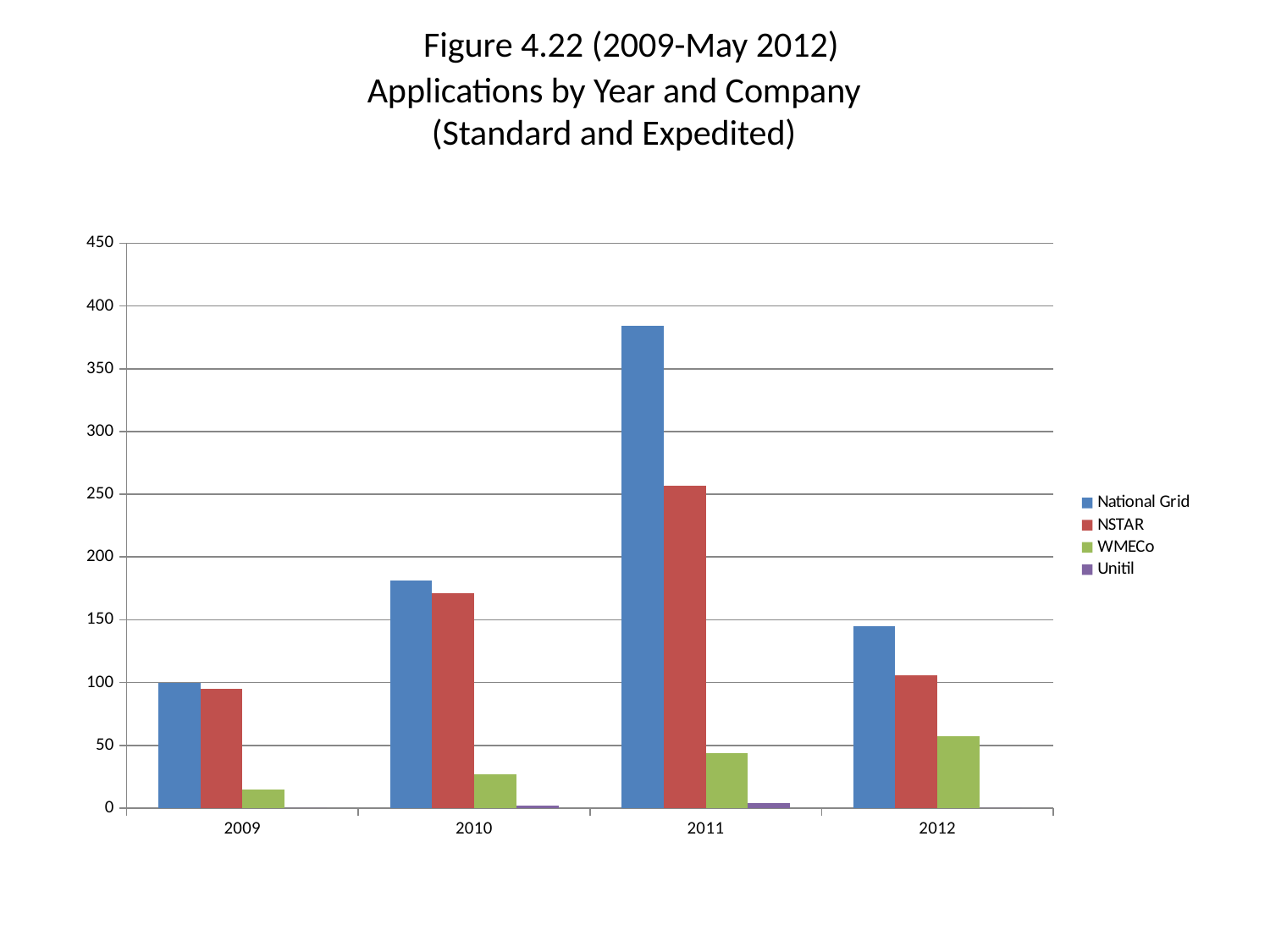
What kind of chart is shown on the slide? bar chart Is the value for National Grid in 2011 greater or less than 350? greater How many years are shown on the x axis? 4 In 2012, which is larger, National Grid or NSTAR? National Grid Do the National Grid values rise or fall from 2009 to 2011? rise Is the value for WMECo in 2012 greater or less than 100? less Which company has the lowest value in 2011? Unitil How many series does the legend list? 4 In which year is the National Grid bar highest? 2011 Is the value for NSTAR in 2011 greater or less than 300? less What colour represents NSTAR in the legend? red